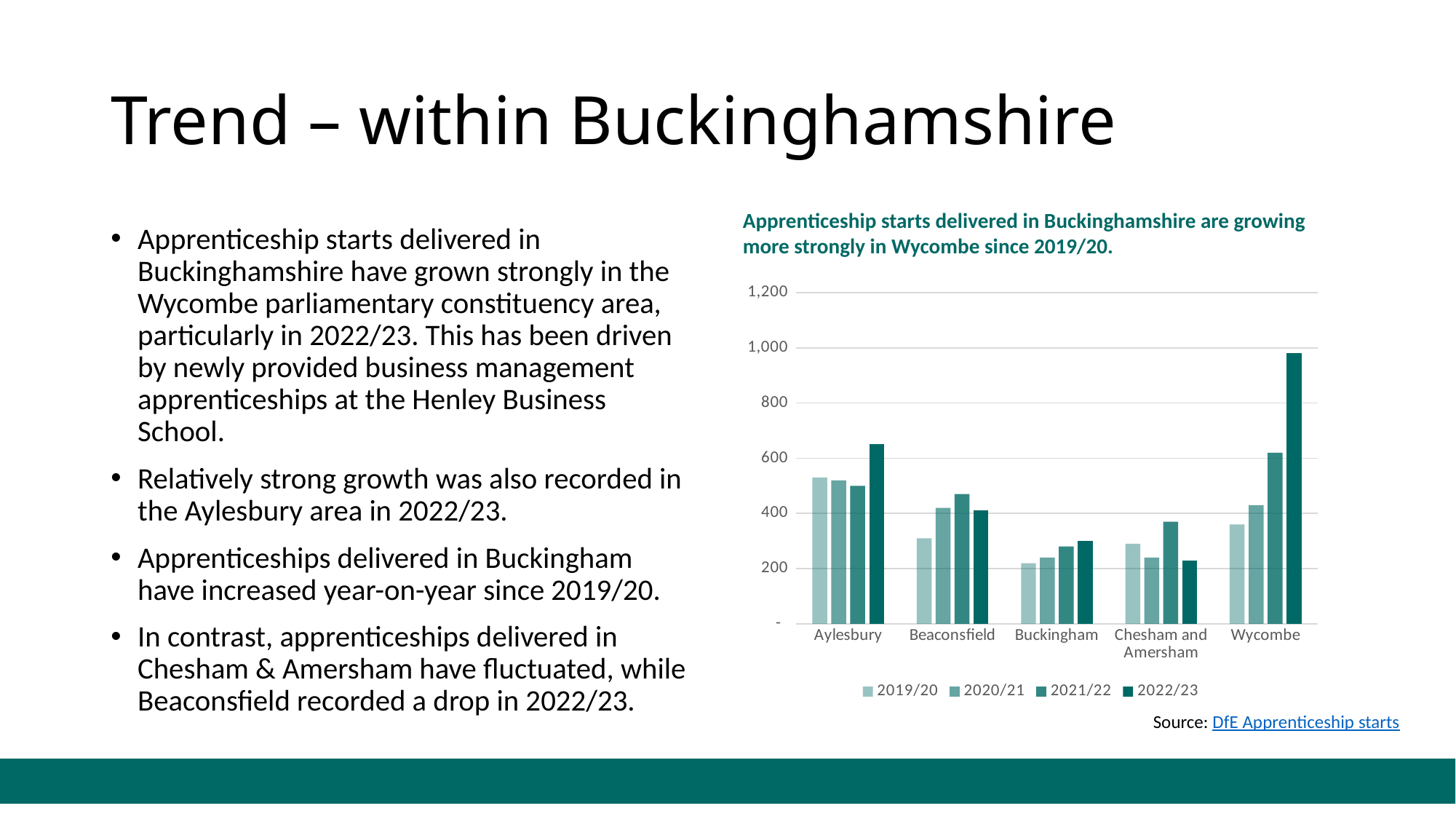
Which is larger: the 2022/23 value for Aylesbury or the 2022/23 value for Beaconsfield? Aylesbury How many series does the chart's legend list? 4 Which is larger: the 2021/22 value for Wycombe or the 2021/22 value for Aylesbury? Wycombe Which constituency has the highest 2022/23 bar in the chart? Wycombe Which constituency has the lowest 2019/20 bar in the chart? Buckingham Do the bars for Buckingham rise or fall from 2019/20 to 2022/23? rise Is the 2022/23 value for Aylesbury greater or less than 600? greater Is the 2019/20 value for Buckingham greater or less than 400? less What is the title of the chart? Apprenticeship starts delivered in Buckinghamshire are growing more strongly in Wycombe since 2019/20. How many parliamentary constituency areas are shown on the x axis of the chart? 5 Is the 2022/23 value for Wycombe greater or less than 800? greater What kind of chart is shown on the slide? bar chart